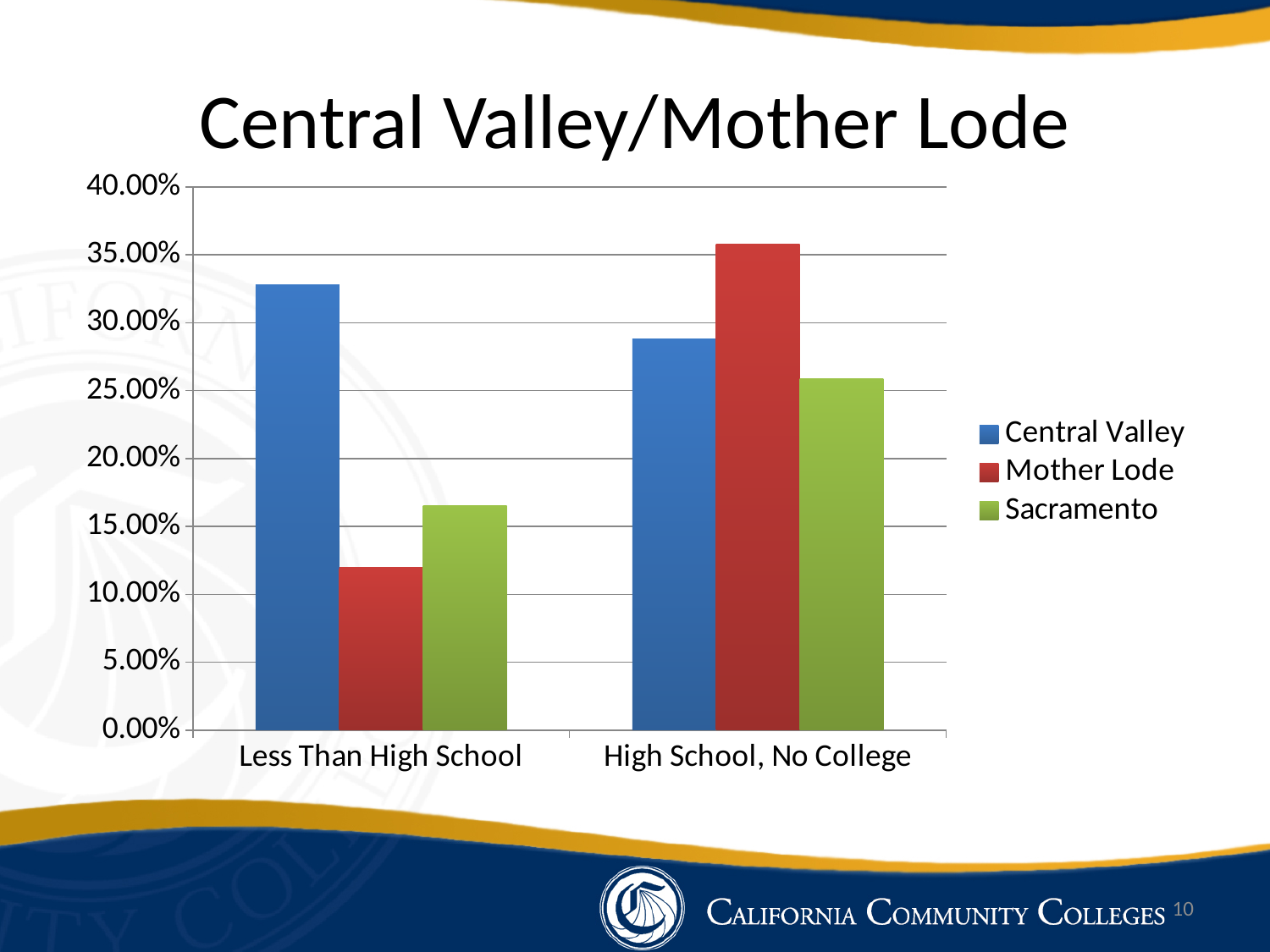
What kind of chart is shown on the slide? bar chart Is the value for Central Valley in Less Than High School greater or less than 30.00%? greater Which is larger: Sacramento for Less Than High School or Sacramento for High School, No College? High School, No College Is the value for Mother Lode in Less Than High School greater or less than 15.00%? less How many categories are shown on the x axis? 2 How many series does the legend list? 3 Which series has the highest value for Less Than High School? Central Valley Which series has the lowest value for Less Than High School? Mother Lode What is the title of the chart? Central Valley/Mother Lode Which series has the highest value for High School, No College? Mother Lode Is the value for Mother Lode in High School, No College greater or less than 35.00%? greater Which series has the lowest value for High School, No College? Sacramento